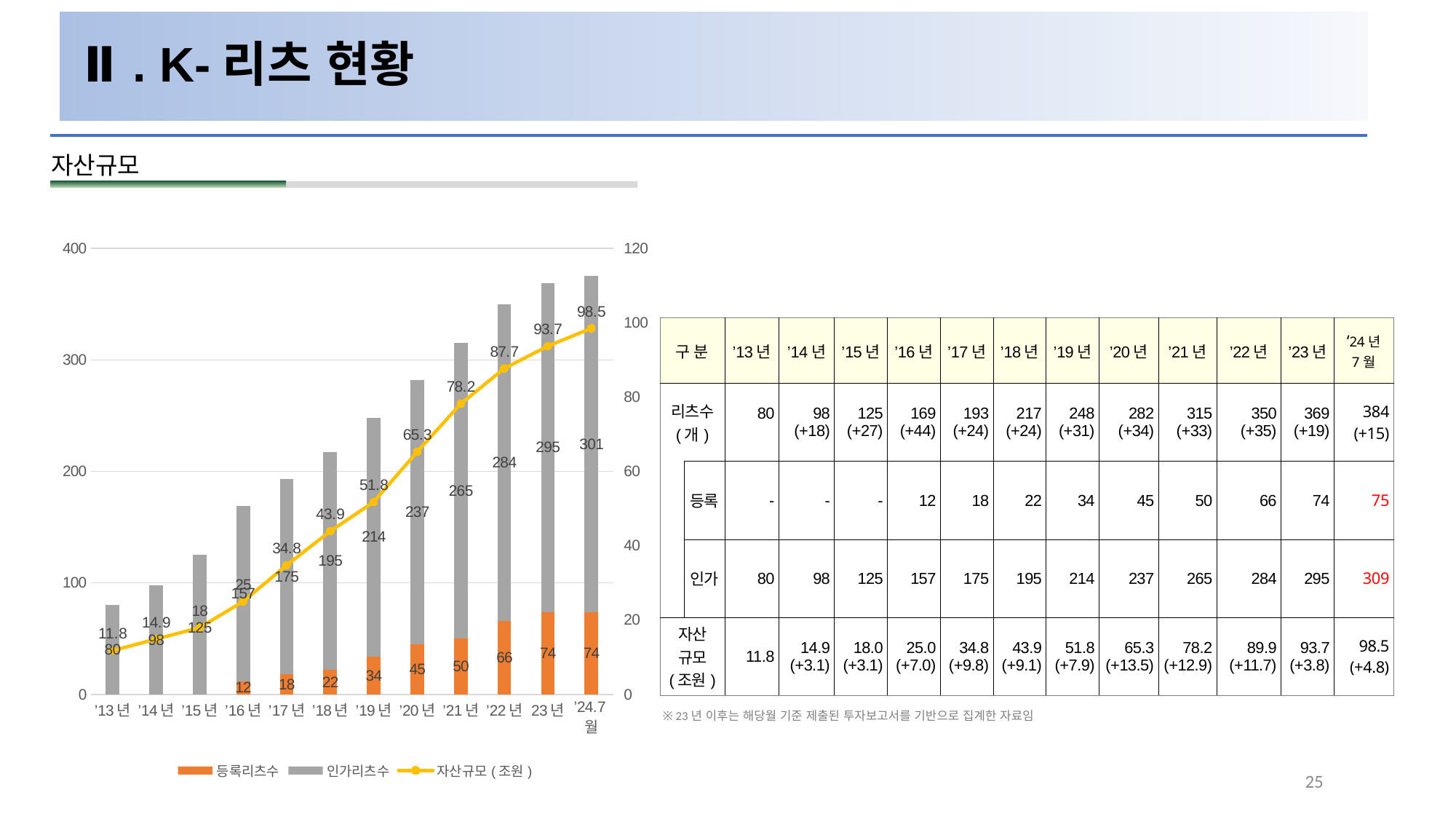
Which is larger in the chart: 등록리츠수 for '19년 or 등록리츠수 for '20년? '20년 Does the 자산규모 (조원) line rise or fall from '13년 to '24.7월? Rise What is the difference between the 인가리츠수 values for '22년 and '21년 in the chart? 19 What is the value of 등록리츠수 for '21년 in the chart? 50 How many series does the chart legend list? 3 Which category has the highest 자산규모 (조원) value in the chart? '24.7월 What is the total of the stacked bar for '23년 (등록리츠수 plus 인가리츠수) in the chart? 369 What is the value of 자산규모 (조원) for '20년 in the chart? 65.3 Which category has the lowest 인가리츠수 value in the chart? '13년 What is the value of 인가리츠수 for '18년 in the chart? 195 What type of chart is shown on the slide? Combined bar and line chart How many categories are shown along the x axis of the chart? 12